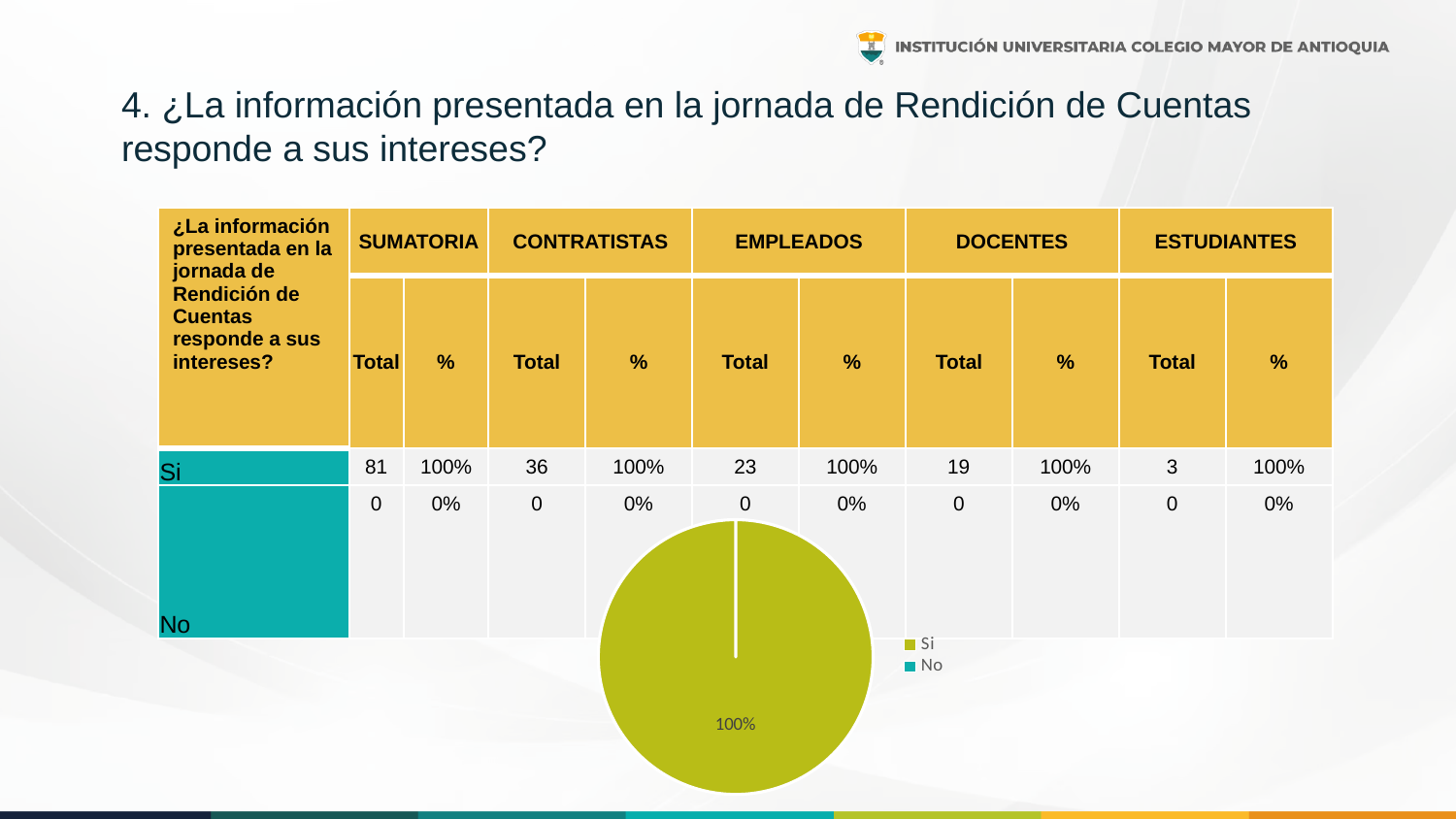
What are the two entries listed in the pie chart's legend? Si and No How many entries does the pie chart's legend list? 2 Which legend category has no visible slice in the pie chart? No Is the share for "Si" in the pie chart greater or less than 50%? greater Which is larger in the pie chart, the share for "Si" or the share for "No"? Si What kind of chart is shown on the slide? pie chart What share of the pie chart does the "Si" slice take up? 100% How many visible slices does the pie chart have? 1 What percentage is printed on the pie chart's slice? 100% Which category takes up the largest share of the pie chart? Si